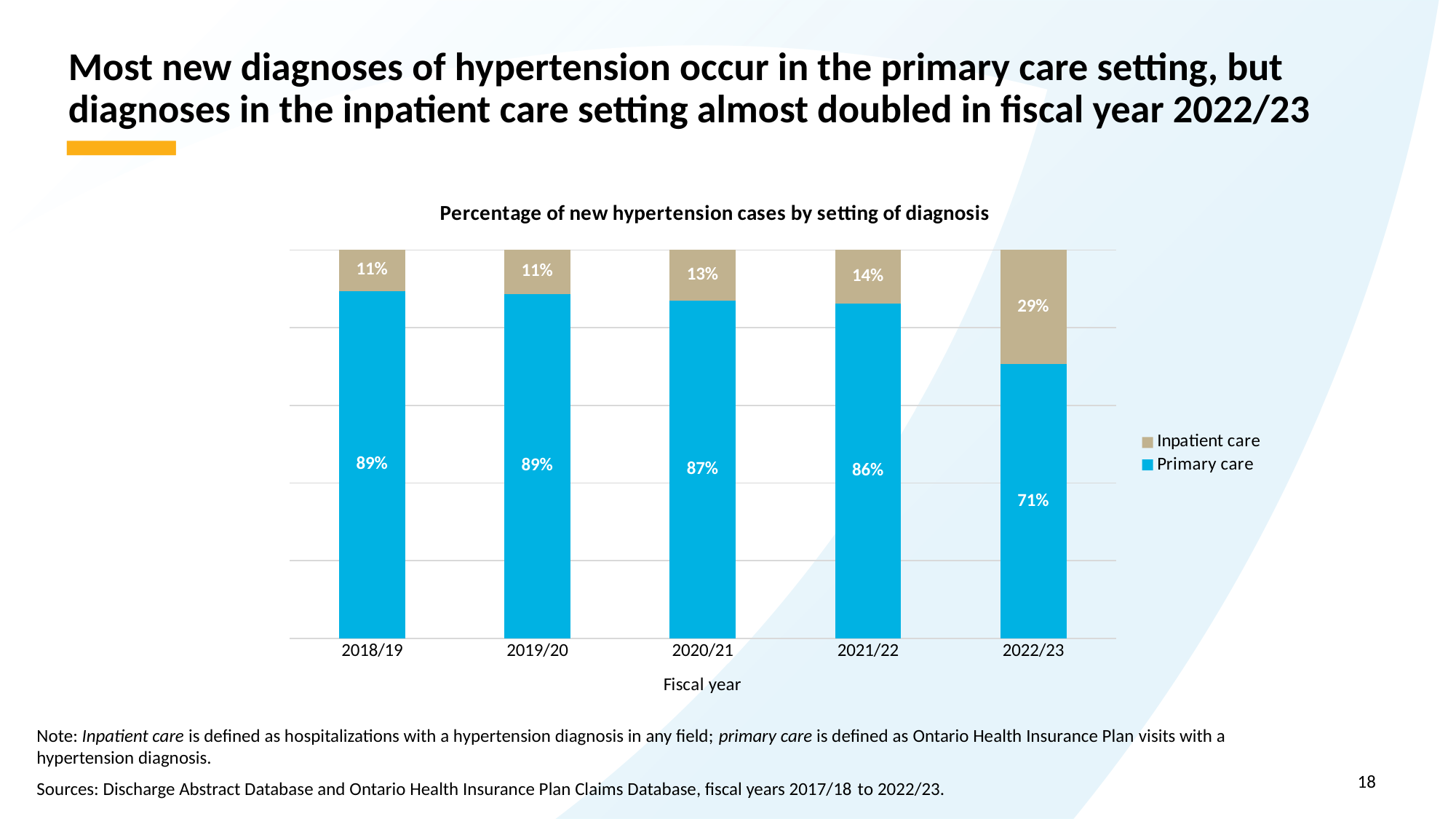
What percentage of new hypertension cases were diagnosed in inpatient care in 2020/21? 13% How many fiscal years are shown on the x axis? 5 What percentage of new hypertension cases were diagnosed in primary care in 2022/23? 71% What is the title of the chart? Percentage of new hypertension cases by setting of diagnosis Does the inpatient care percentage rise or fall from 2018/19 to 2022/23? Rise Which fiscal year has the lowest primary care percentage? 2022/23 What is the inpatient care value for 2018/19? 11% Which fiscal year has the highest inpatient care percentage? 2022/23 What is the difference between the inpatient care percentages for 2022/23 and 2021/22? 15% Which is larger, the primary care value for 2019/20 or for 2021/22? 2019/20 What kind of chart is shown on the slide? Stacked bar chart How many series does the legend list? 2